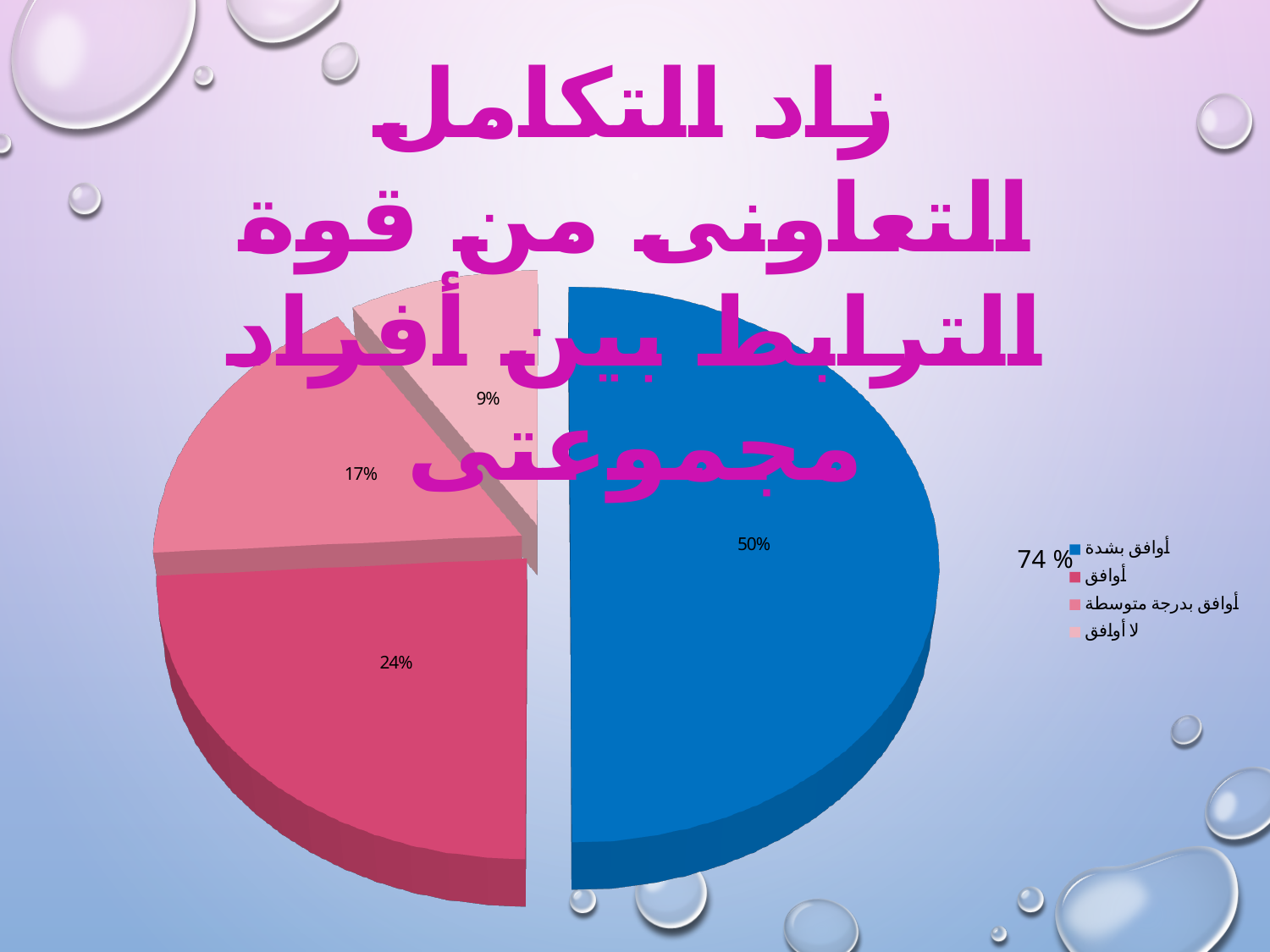
Which category has the smallest slice of the pie? لا أوافق What percentage of the pie is labelled for "أوافق بدرجة متوسطة"? 17% Which slice is larger, "أوافق بدرجة متوسطة" or "لا أوافق"? أوافق بدرجة متوسطة What percentage of the pie is labelled for "أوافق"? 24% What percentage of the pie is labelled for "لا أوافق"? 9% What kind of chart is shown on the slide? pie chart What percentage of the pie is labelled for "أوافق بشدة"? 50% Which category has the largest slice of the pie? أوافق بشدة What is the difference in percentage points between the "أوافق بشدة" slice and the "أوافق" slice? 26 How many slices does the pie chart have? 4 How many entries does the legend list? 4 What colour is the "أوافق بشدة" slice? blue